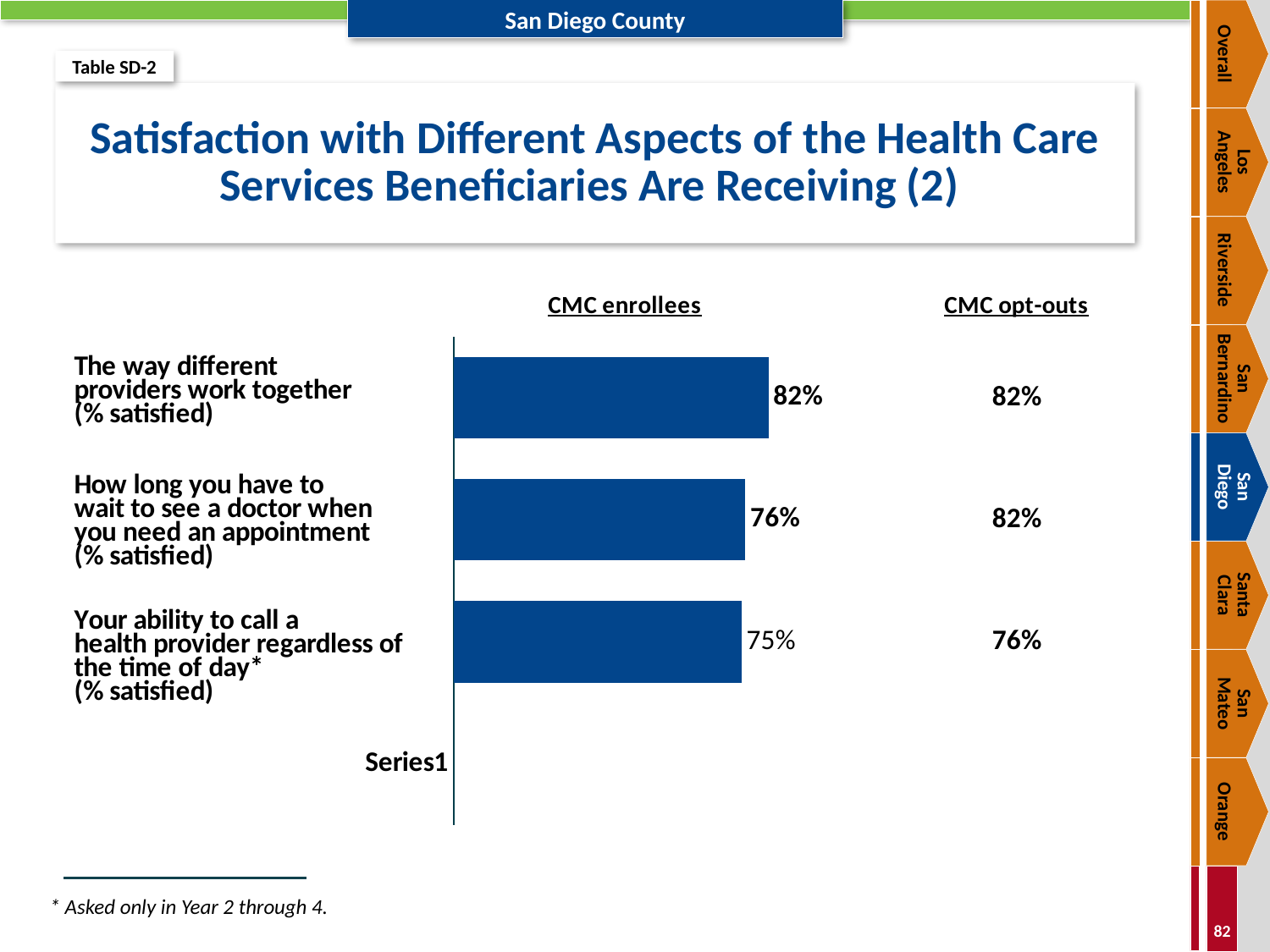
Which aspect has the highest satisfaction among CMC enrollees? The way different providers work together What percentage of CMC enrollees are satisfied with how long they have to wait to see a doctor when they need an appointment? 76% What percentage of CMC opt-outs are satisfied with how long they have to wait to see a doctor when they need an appointment? 82% What percentage of CMC enrollees are satisfied with the way different providers work together? 82% How many bars are plotted in the chart? 3 Which aspect has the lowest satisfaction among CMC enrollees? Your ability to call a health provider regardless of the time of day For how long you have to wait to see a doctor, which group reports higher satisfaction, CMC enrollees or CMC opt-outs? CMC opt-outs What percentage of CMC opt-outs are satisfied with their ability to call a health provider regardless of the time of day? 76% What is the difference in CMC enrollee satisfaction between the way different providers work together and the ability to call a health provider regardless of the time of day? 7 percentage points What type of chart is used to show the CMC enrollee satisfaction values? Bar chart What percentage of CMC enrollees are satisfied with their ability to call a health provider regardless of the time of day? 75% What is the title of the chart on this slide? Satisfaction with Different Aspects of the Health Care Services Beneficiaries Are Receiving (2)